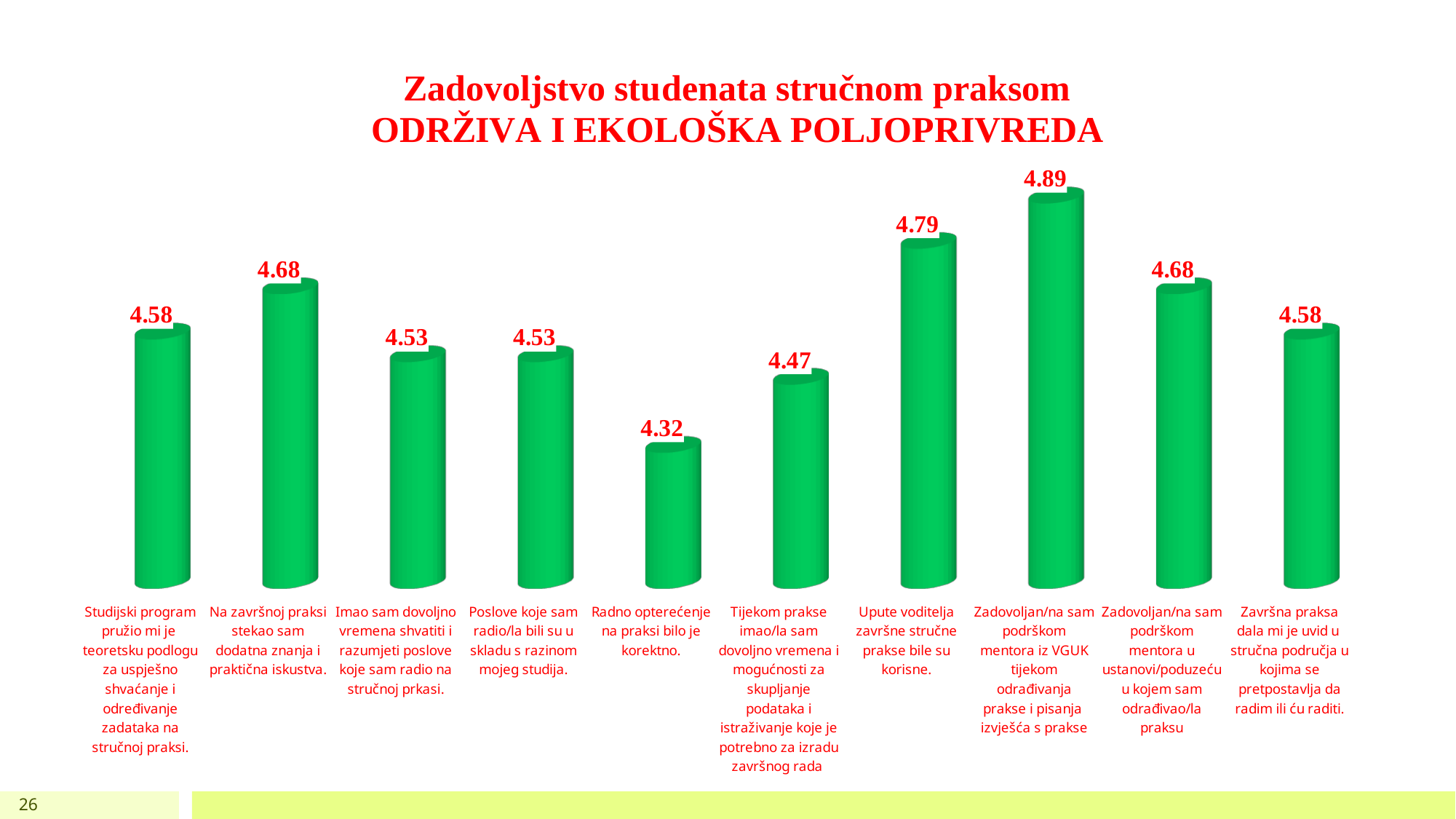
What kind of chart is shown on the slide? Bar chart What is the difference between the value for "Upute voditelja završne stručne prakse bile su korisne." and the value for "Tijekom prakse imao/la sam dovoljno vremena i mogućnosti za skupljanje podataka i istraživanje koje je potrebno za izradu završnog rada"? 0.32 Which is larger: the value for "Studijski program pružio mi je teoretsku podlogu..." or the value for "Na završnoj praksi stekao sam dodatna znanja i praktična iskustva."? Na završnoj praksi stekao sam dodatna znanja i praktična iskustva. Which category has the lowest value? Radno opterećenje na praksi bilo je korektno. Which category has the highest value? Zadovoljan/na sam podrškom mentora iz VGUK tijekom odrađivanja prakse i pisanja izvješća s prakse What is the value for "Na završnoj praksi stekao sam dodatna znanja i praktična iskustva."? 4.68 What is the value for "Radno opterećenje na praksi bilo je korektno."? 4.32 How many categories (bars) are shown in the chart? 10 What is the difference between the highest value (4.89) and the lowest value (4.32)? 0.57 What is the title of the chart? Zadovoljstvo studenata stručnom praksom ODRŽIVA I EKOLOŠKA POLJOPRIVREDA What is the value for "Upute voditelja završne stručne prakse bile su korisne."? 4.79 What is the value for "Završna praksa dala mi je uvid u stručna područja u kojima se pretpostavlja da radim ili ću raditi."? 4.58